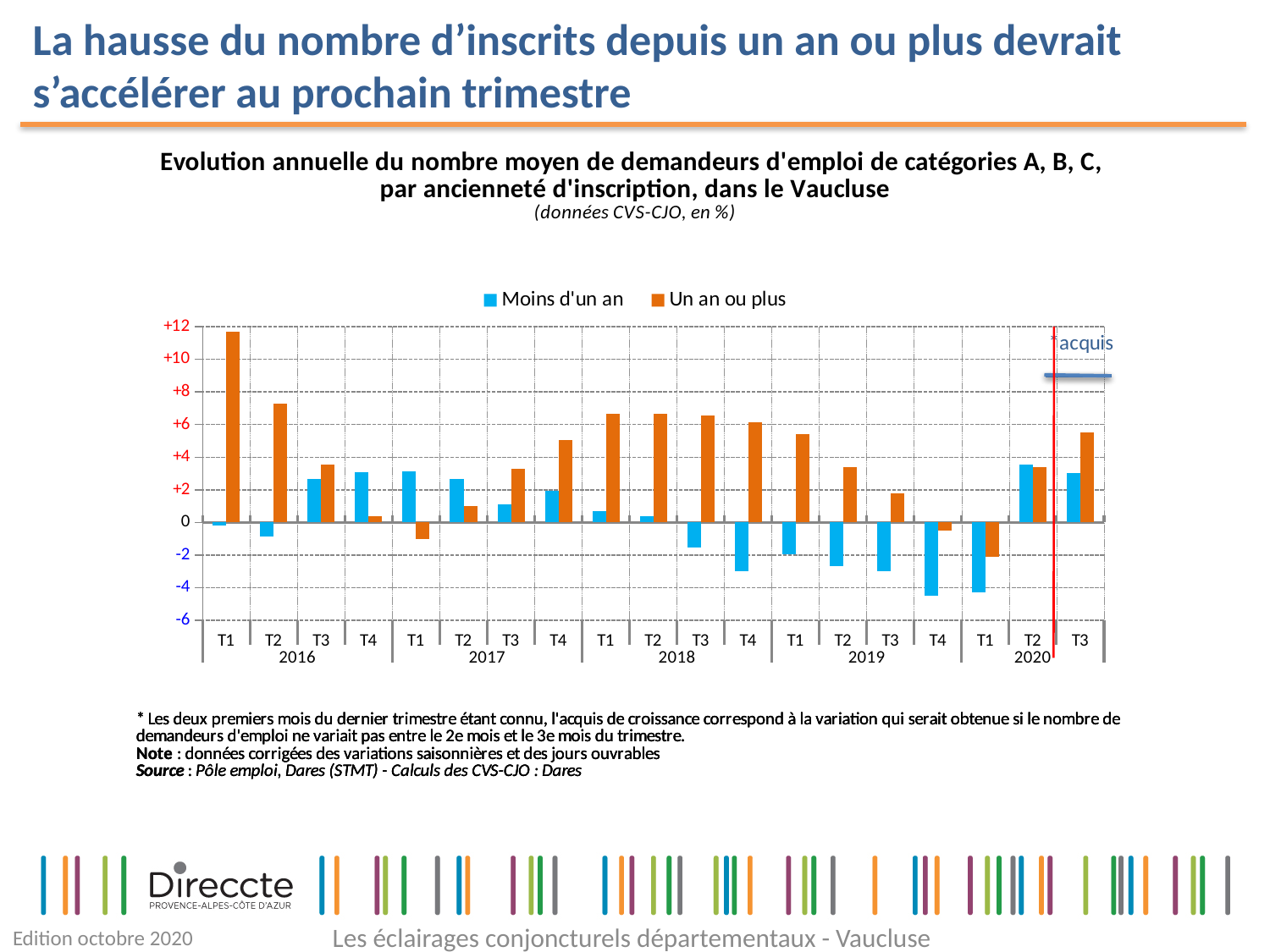
How many series does the legend list? 2 Is the value for 'Un an ou plus' in T1 2016 greater or less than +10? greater In which quarter is the value for 'Un an ou plus' the highest? T1 2016 Is the value for 'Un an ou plus' in T1 2018 greater or less than +6? greater Is the value for 'Un an ou plus' in T3 2020 greater or less than +4? greater In T1 2019, which series has the larger value, 'Moins d'un an' or 'Un an ou plus'? Un an ou plus In T1 2017, which series has the larger value, 'Moins d'un an' or 'Un an ou plus'? Moins d'un an Do the values for 'Un an ou plus' rise or fall from T1 2018 to T4 2019? fall What kind of chart is shown on the slide? bar chart What are the two series named in the legend? Moins d'un an; Un an ou plus How many quarters are plotted along the x axis? 19